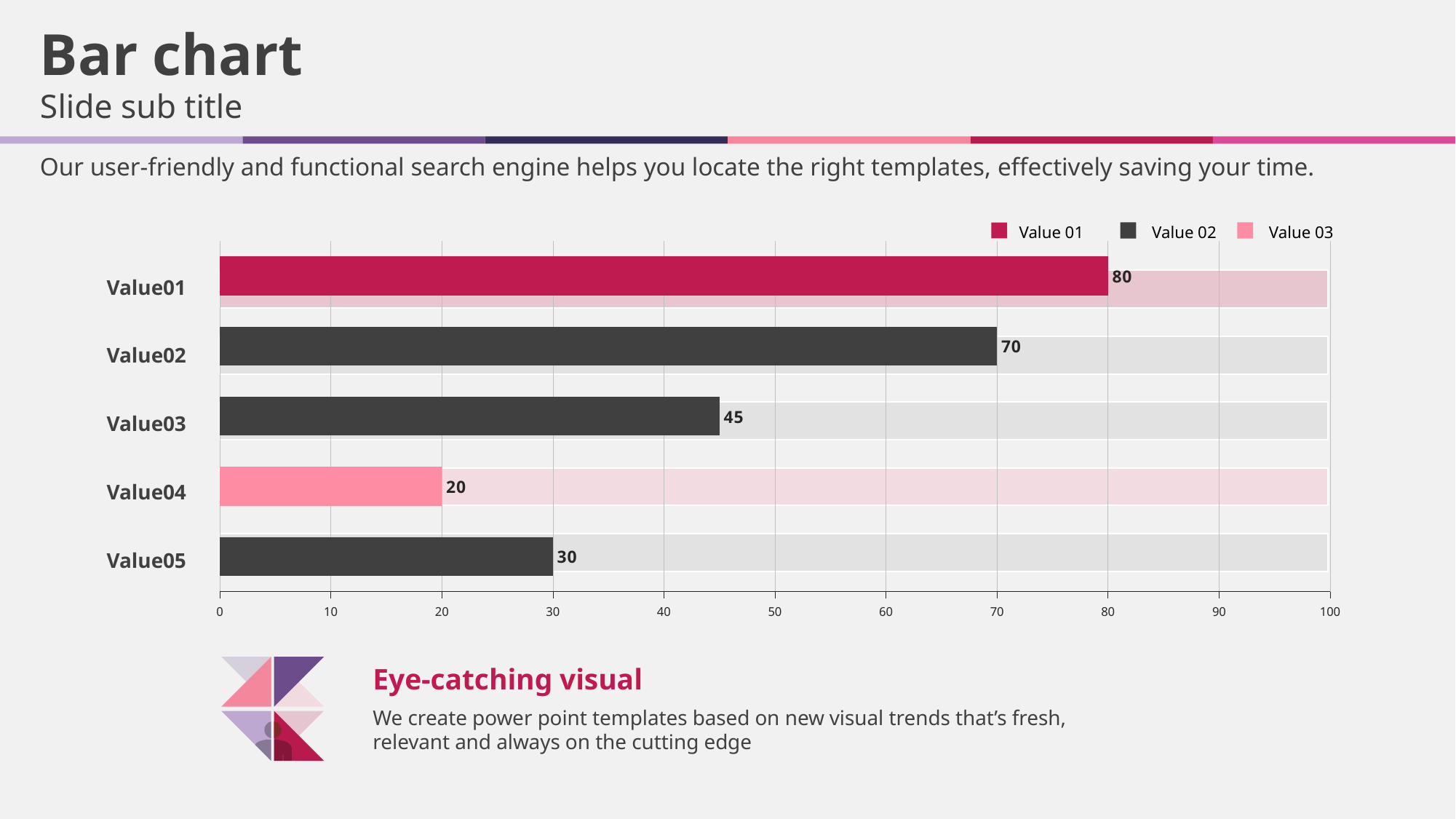
How many series does the legend list? 3 Which is larger, the value for Value05 or the value for Value04? Value05 Is the value for Value02 greater or less than 60? greater What is the value for Value03? 45 What is the difference between the values for Value03 and Value05? 15 What is the value for Value01? 80 What kind of chart is shown on the slide? Bar chart Which category has the lowest value? Value04 What is the difference between the values for Value01 and Value02? 10 How many categories are shown on the chart? 5 What is the value for Value04? 20 Which category has the highest value? Value01